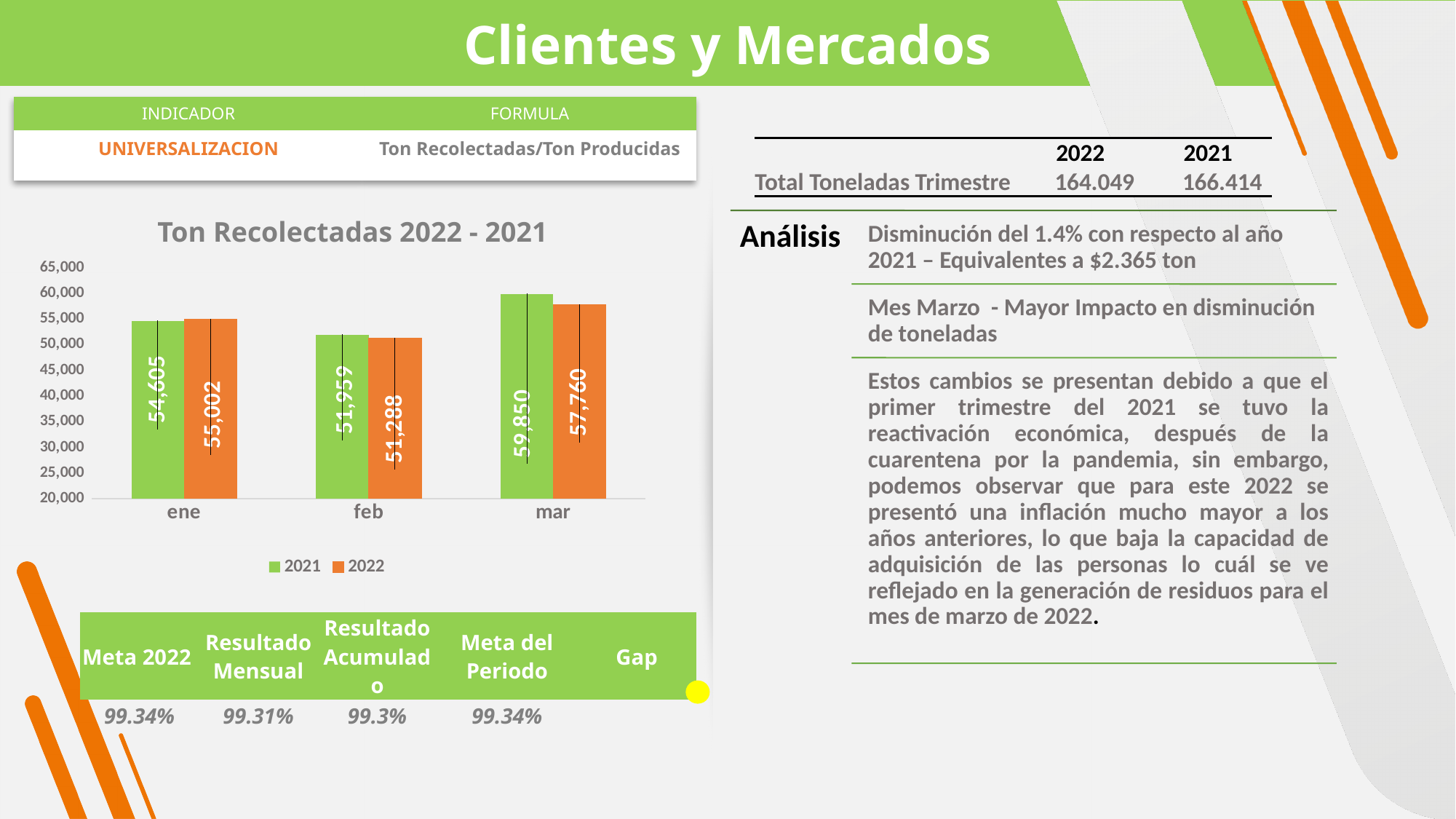
What is the value for 2022 in mar? 57,760 In ene, which series has the larger value, 2021 or 2022? 2022 What type of chart is shown on the slide? bar chart Which month has the lowest value for the 2022 series? feb What is the value for 2021 in ene? 54,605 What is the title of the chart on the slide? Ton Recolectadas 2022 - 2021 How many categories are shown on the x axis of the chart? 3 What is the difference between the 2021 and 2022 values in mar? 2,090 How many series does the chart legend list? 2 Which colour represents the 2022 series in the chart? orange What is the value for 2022 in feb? 51,288 Which month has the highest value for the 2021 series? mar